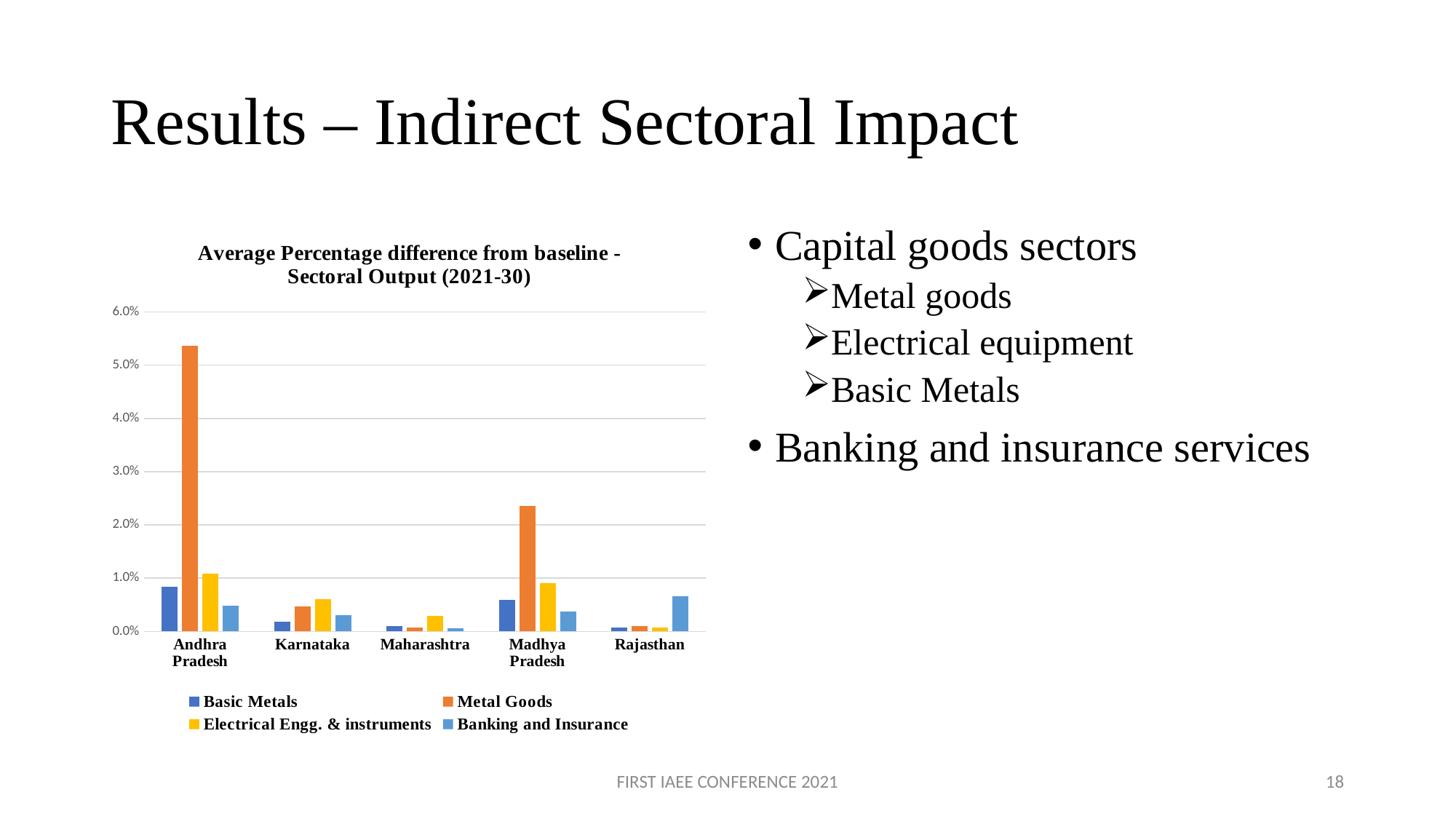
Which state has the highest Metal Goods value? Andhra Pradesh Is the Metal Goods value for Andhra Pradesh greater or less than 5.0%? greater How many states are shown on the x axis of the chart? 5 Which is larger, the Banking and Insurance value for Rajasthan or for Karnataka? Rajasthan What kind of chart is shown on the slide? Bar chart What is the title of the chart? Average Percentage difference from baseline - Sectoral Output (2021-30) Is the Basic Metals value for Andhra Pradesh greater or less than 1.0%? less Which state has the highest Electrical Engg. & instruments value? Andhra Pradesh How many series does the chart's legend list? 4 In Rajasthan, which series has the highest value? Banking and Insurance Is the Metal Goods value for Madhya Pradesh greater or less than 3.0%? less Which is larger, the Metal Goods value for Andhra Pradesh or for Madhya Pradesh? Andhra Pradesh